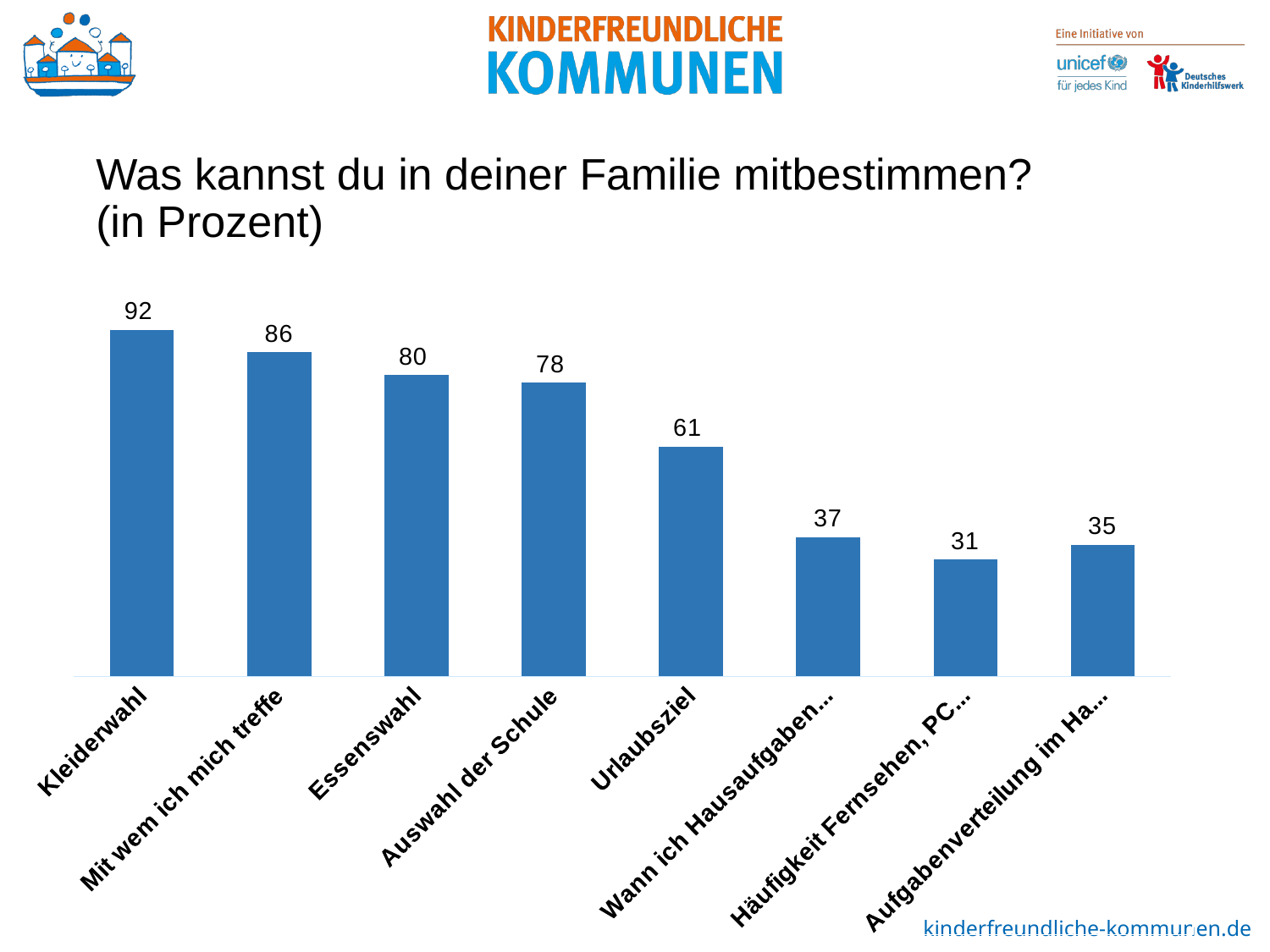
Which category has the highest value? Kleiderwahl What is the value for Kleiderwahl? 92 What is the value for Auswahl der Schule? 78 What is the value for Urlaubsziel? 61 What is the title of the chart on the slide? Was kannst du in deiner Familie mitbestimmen? (in Prozent) Which is larger, the value for Essenswahl or the value for Auswahl der Schule? Essenswahl How many categories are shown in the chart? 8 Which category has the lowest value? Häufigkeit Fernsehen, PC... What is the difference between the values for Kleiderwahl and Mit wem ich mich treffe? 6 What kind of chart is shown on the slide? bar chart What is the difference between the values for Urlaubsziel and Wann ich Hausaufgaben...? 24 What is the value for Essenswahl? 80